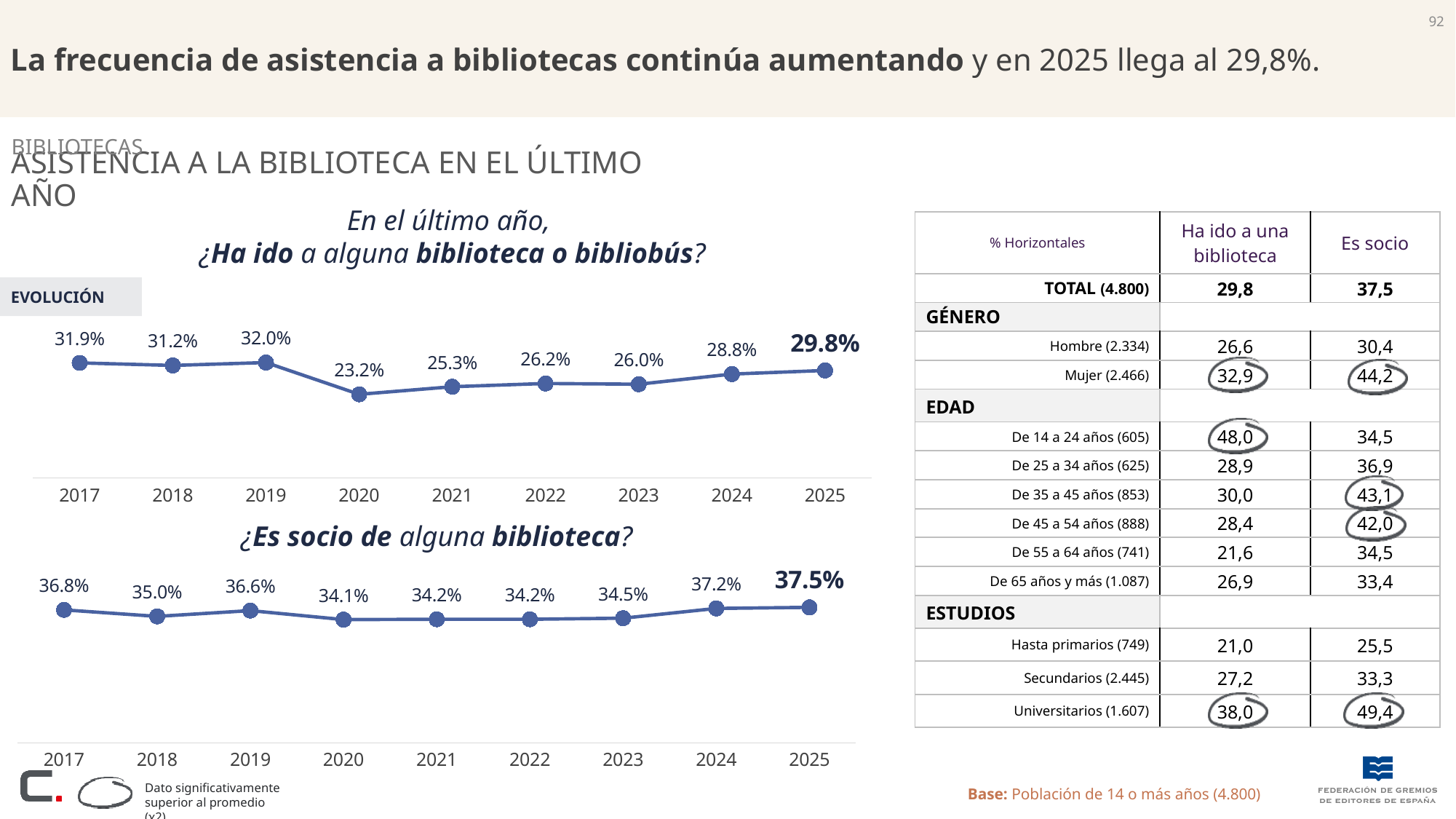
In the bottom chart (¿Es socio de alguna biblioteca?), which year has the lowest value? 2020 In the top chart (¿Ha ido a alguna biblioteca o bibliobús?), which year has the highest value? 2019 In the bottom chart (¿Es socio de alguna biblioteca?), what is the value for 2025? 37.5% How many years are plotted in the top chart (¿Ha ido a alguna biblioteca o bibliobús?)? 9 In the bottom chart (¿Es socio de alguna biblioteca?), what is the difference between the 2024 value and the 2023 value? 2.7 percentage points In the top chart (¿Ha ido a alguna biblioteca o bibliobús?), what is the value for 2020? 23.2% In the bottom chart (¿Es socio de alguna biblioteca?), which is larger, the value for 2017 or the value for 2019? 2017 In the bottom chart (¿Es socio de alguna biblioteca?), what is the value for 2018? 35.0% What kind of chart is the bottom chart (¿Es socio de alguna biblioteca?)? Line chart In the top chart (¿Ha ido a alguna biblioteca o bibliobús?), which year has the lowest value? 2020 In the top chart (¿Ha ido a alguna biblioteca o bibliobús?), what is the value for 2025? 29.8% In the top chart (¿Ha ido a alguna biblioteca o bibliobús?), what is the difference between the 2025 value and the 2020 value? 6.6 percentage points